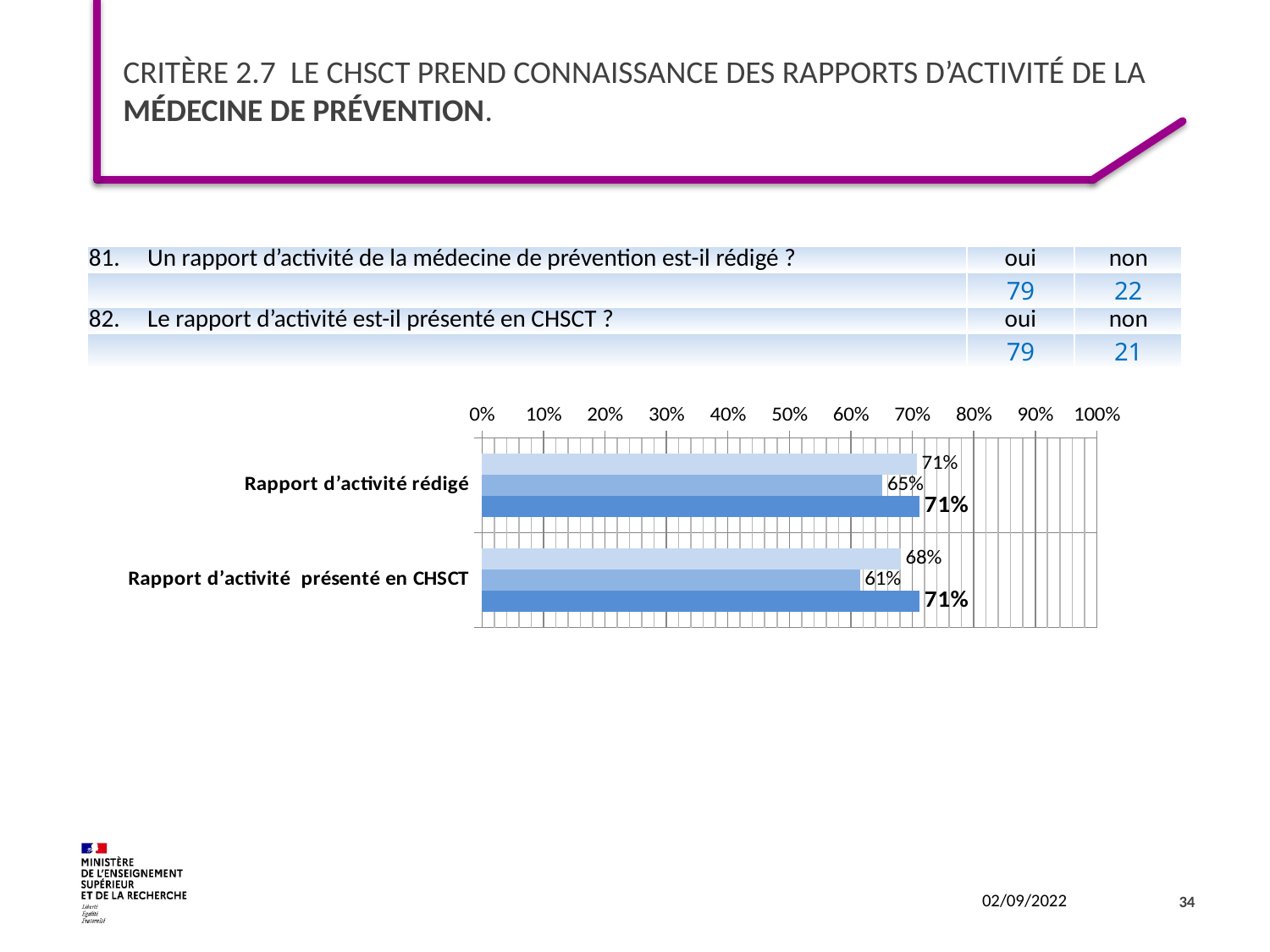
What is the difference between the middle bar for "Rapport d'activité rédigé" and the middle bar for "Rapport d'activité présenté en CHSCT"? 4 percentage points What kind of chart is shown on the slide? bar chart What is the value of the middle bar for "Rapport d'activité rédigé"? 65% What is the value of the top (lightest blue) bar for "Rapport d'activité présenté en CHSCT"? 68% What is the highest value shown on the chart's horizontal axis? 100% What is the difference between the top bar for "Rapport d'activité rédigé" (71%) and the top bar for "Rapport d'activité présenté en CHSCT" (68%)? 3 percentage points How many bars are drawn for each category on the chart? 3 What is the lowest value labelled on the chart? 61% What is the value of the bottom (darkest blue, bold-labelled) bar for "Rapport d'activité rédigé"? 71% What is the value of the middle bar for "Rapport d'activité présenté en CHSCT"? 61% How many categories are shown on the chart's vertical axis? 2 Which category has the larger value for its middle bar: "Rapport d'activité rédigé" or "Rapport d'activité présenté en CHSCT"? Rapport d'activité rédigé